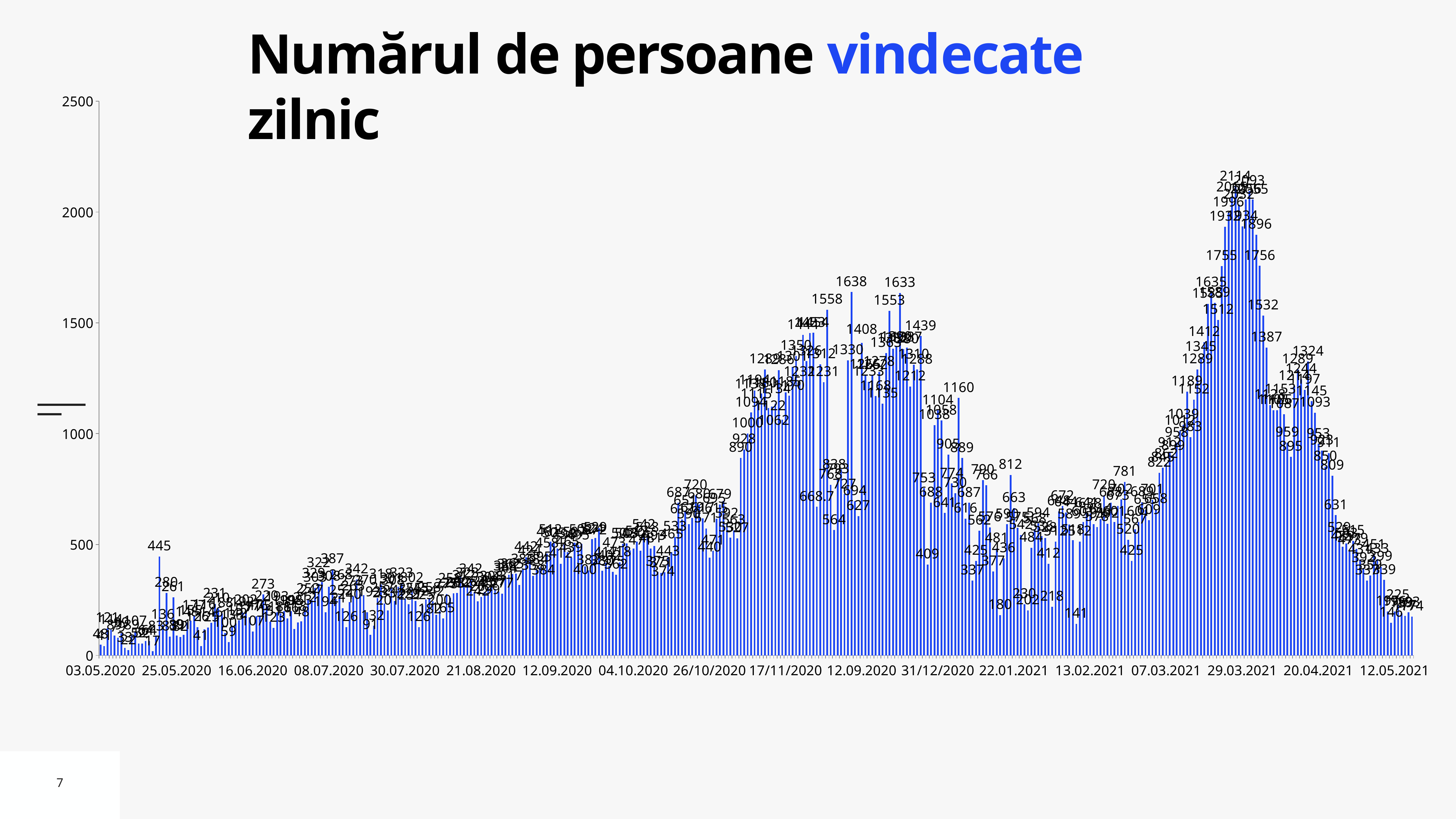
What kind of chart is shown on the slide? bar chart Do the values rise or fall between 29.03.2021 and 12.05.2021? fall Is the value for the last bar at 12.05.2021 greater or less than 500? less What is the title of the chart? Numărul de persoane vindecate zilnic Around which x-axis date does the chart reach its highest peak? 29.03.2021 Which is larger, the peak labelled 1638 or the peak labelled 1558? 1638 What is the difference between the highest value 2114 and the value labelled 1896? 218 What is the value printed on the tall isolated bar near 25.05.2020? 445 What is the highest tick value shown on the y axis? 2500 Is the value for the first bar at 03.05.2020 greater or less than 500? less What is the highest value printed on the chart? 2114 What is the difference between the peak labelled 1638 and the peak labelled 1633? 5